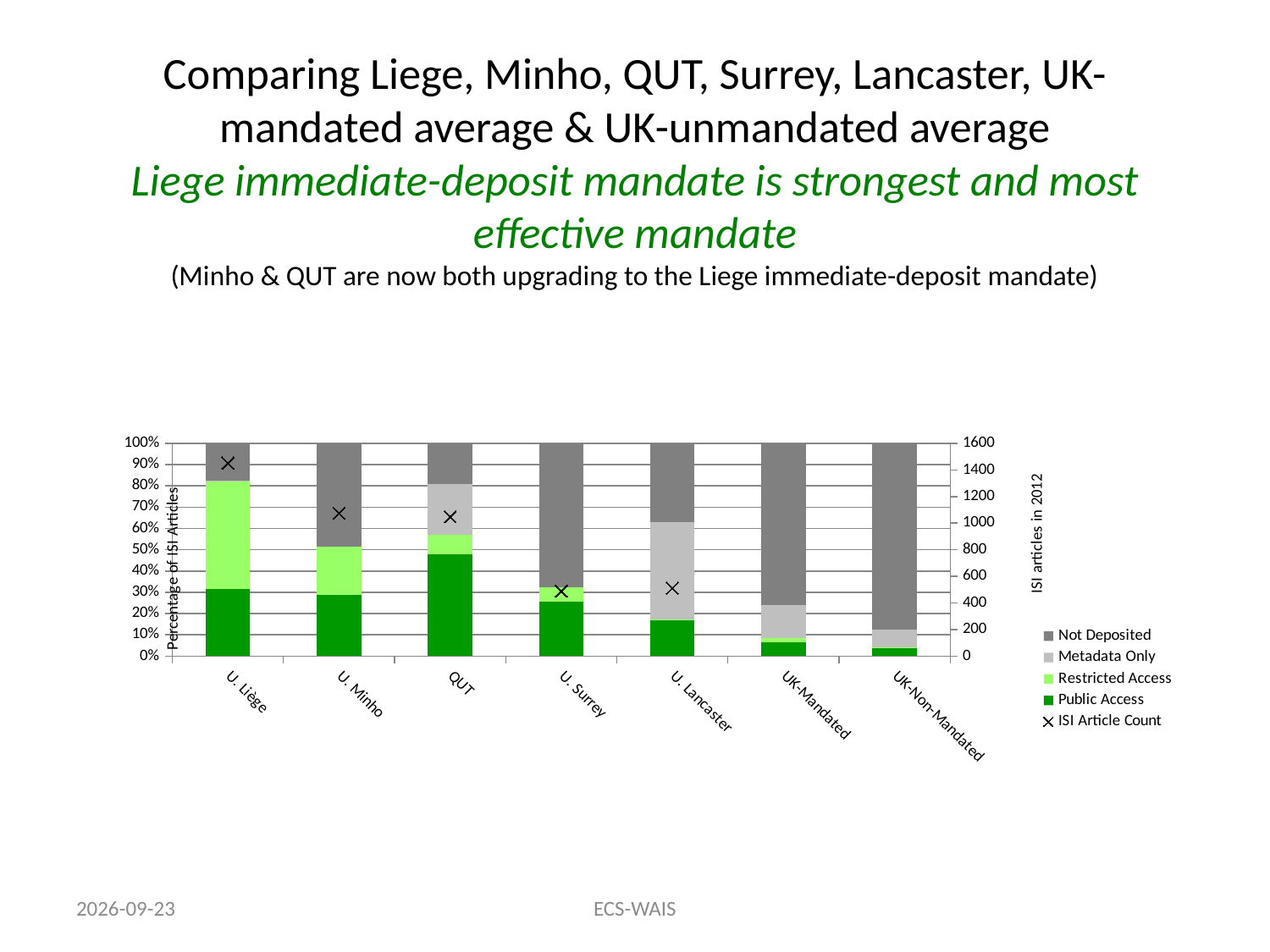
Which category has the lowest Public Access share? UK-Non-Mandated What is the title of the right-hand vertical axis? ISI articles in 2012 Which category has the highest Public Access share? QUT How many categories are shown along the x axis of the chart? 7 Which has the larger Public Access share, QUT or U. Liège? QUT Is the Public Access value for QUT greater or less than 40%? greater Which category has the largest Restricted Access segment? U. Liège Is the ISI Article Count for U. Liège greater or less than 1200? greater Which category has the highest ISI Article Count? U. Liège How many series does the chart's legend list? 5 Is the Public Access value for U. Lancaster greater or less than 20%? less What kind of chart is shown on the slide? Stacked bar chart